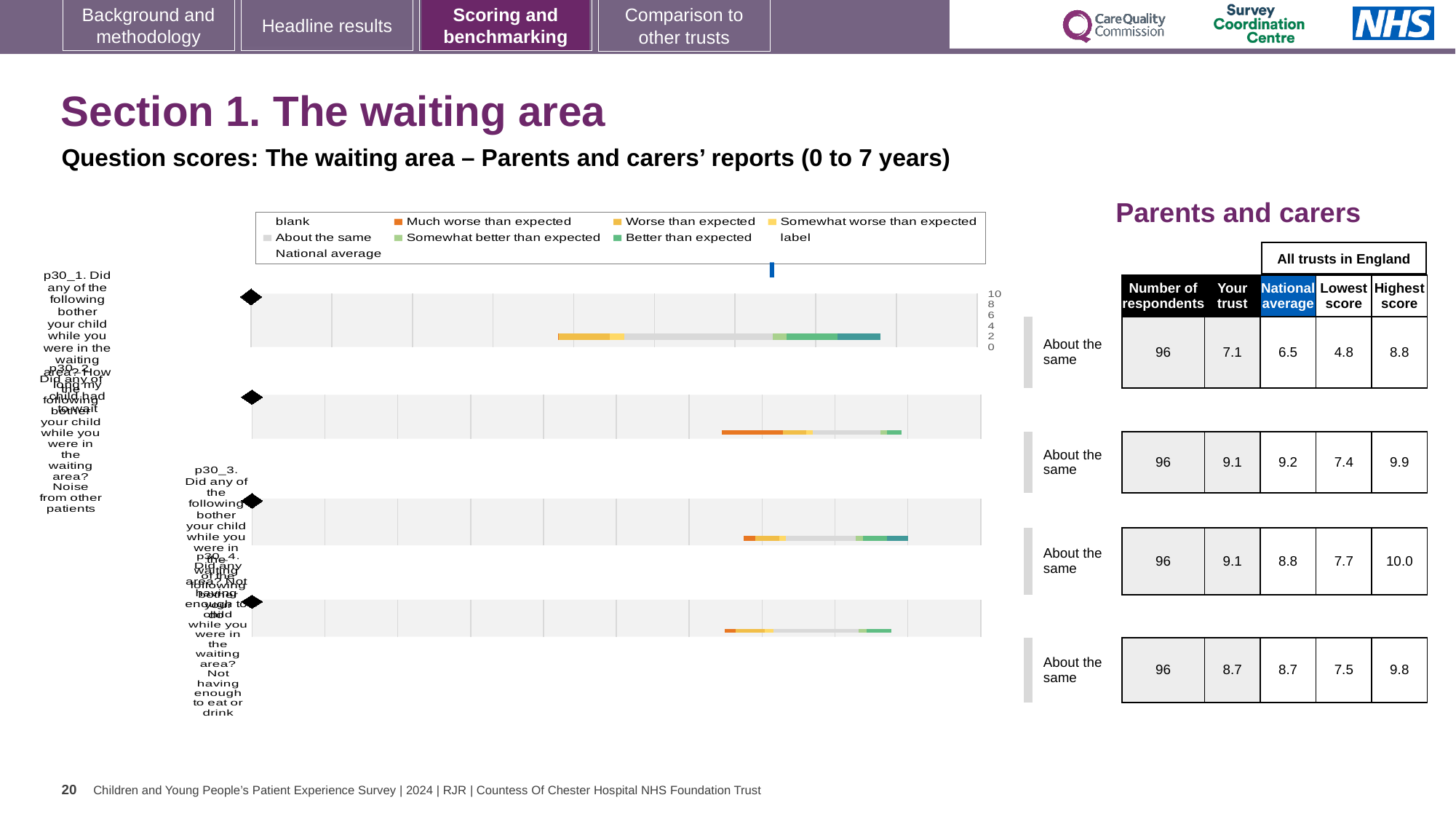
What colour does the legend use for 'Much worse than expected'? orange In the table next to the chart, what is the 'Your trust' score for the first question (p30_1, bother in the waiting area)? 7.1 How many entries does the chart legend list? 9 How many respondents are listed for each question in the table next to the chart? 96 In the table next to the chart, what is the difference between the highest score and the lowest score for the second question (p30_2)? 2.5 In the table next to the chart, what is the national average for the first question (p30_1)? 6.5 What is the highest value shown on the chart's axis? 10 In the table next to the chart, what is the lowest score for the fourth question (p30_4, not having enough to eat or drink)? 7.5 In the table next to the chart, what is the highest score for the third question (p30_3, noise from other patients)? 10.0 How many question bars are plotted in the chart? 4 What kind of chart is shown on the slide? bar chart In the table next to the chart, which question has the lowest 'Your trust' score? p30_1 (bother in the waiting area)